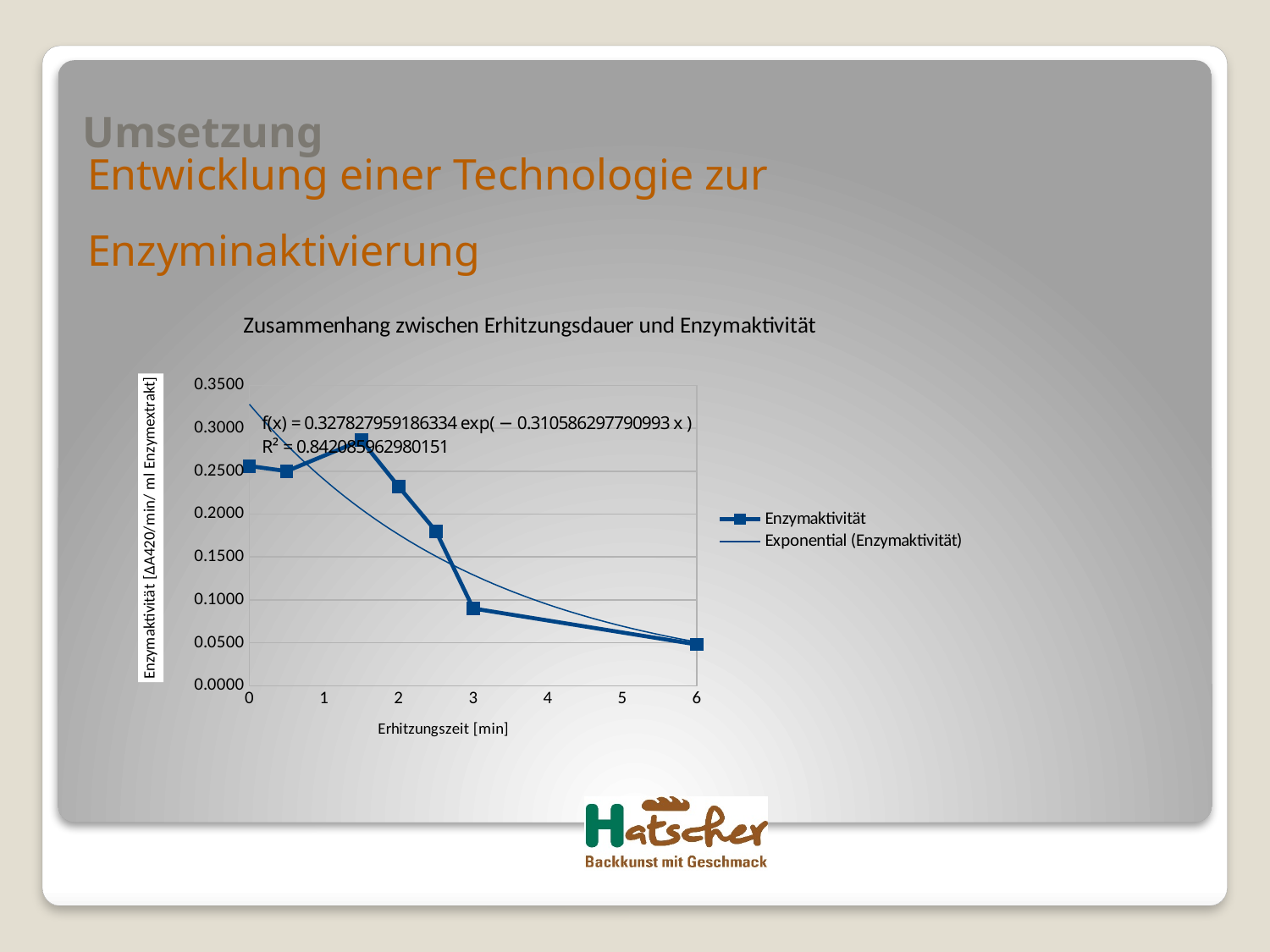
Is the Enzymaktivität at 3 min greater or less than 0.1500? less Which is larger, the Enzymaktivität at 2 min or at 3 min? 2 min Is the Enzymaktivität at 2 min greater or less than 0.2000? greater At which heating time (Erhitzungszeit) is the Enzymaktivität lowest? 6 How many entries does the chart legend list? 2 What is the label of the x axis? Erhitzungszeit [min] What is the title of the chart? Zusammenhang zwischen Erhitzungsdauer und Enzymaktivität Does the Enzymaktivität overall rise or fall as the heating time increases from 1.5 min to 6 min? fall How many data points are plotted for the Enzymaktivität series? 7 Is the Enzymaktivität at 6 min greater or less than 0.1000? less What kind of chart is shown on the slide? line chart